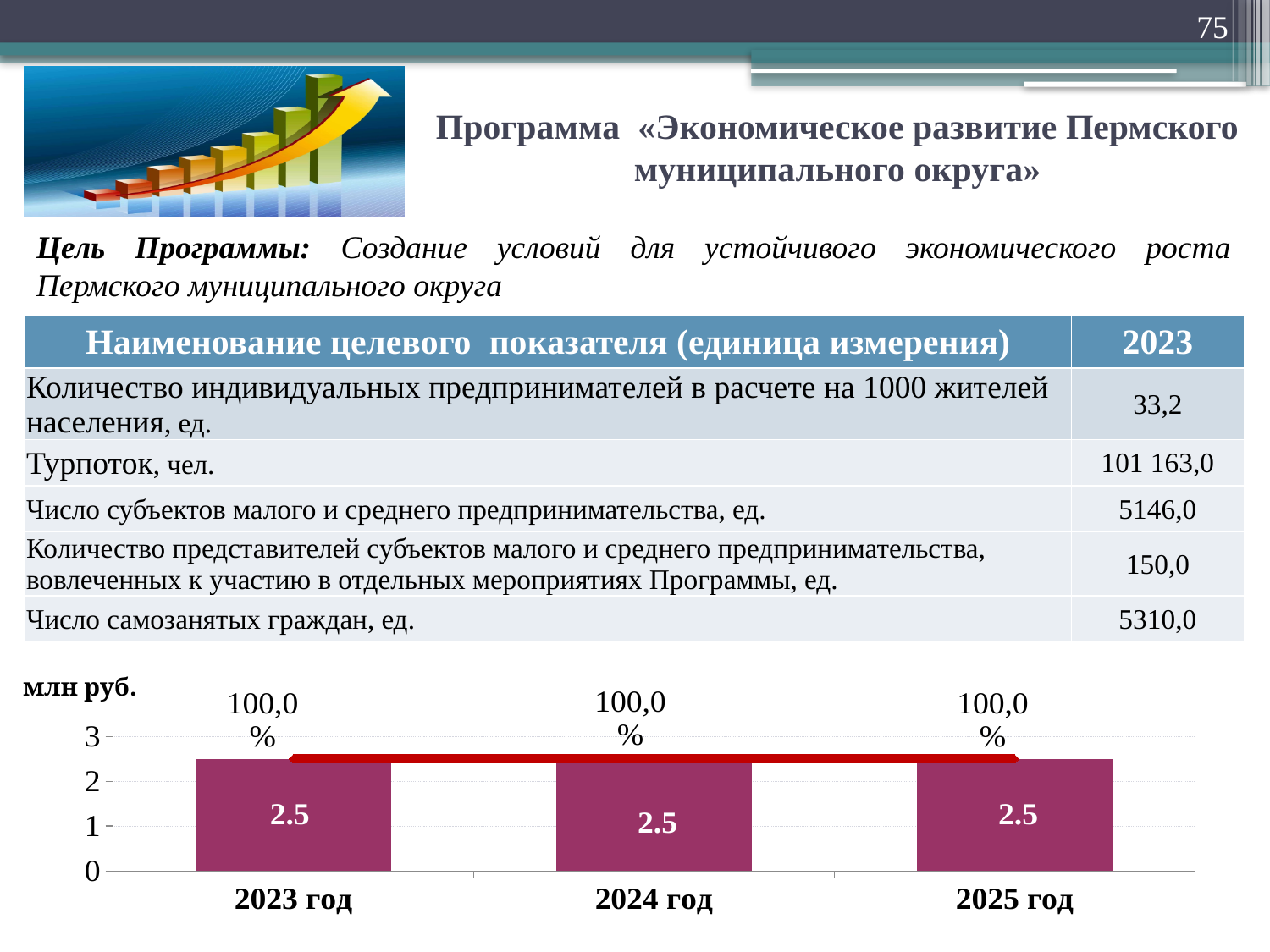
What percentage label is shown above the 2025 год bar? 100,0 % Is the value for 2023 год greater or less than 2? greater What unit is shown above the y axis of the chart? млн руб. Do the bar values rise, fall or stay the same from 2023 год to 2025 год? stay the same What is the highest tick value shown on the y axis? 3 What is the value of the bar for 2025 год? 2.5 What is the value of the bar for 2023 год? 2.5 What is the difference between the values for 2024 год and 2023 год? 0 How many bars (years) are shown in the chart? 3 Is the value for 2025 год greater or less than 3? less What is the value of the bar for 2024 год? 2.5 What kind of chart is shown at the bottom of the slide? combination bar and line chart